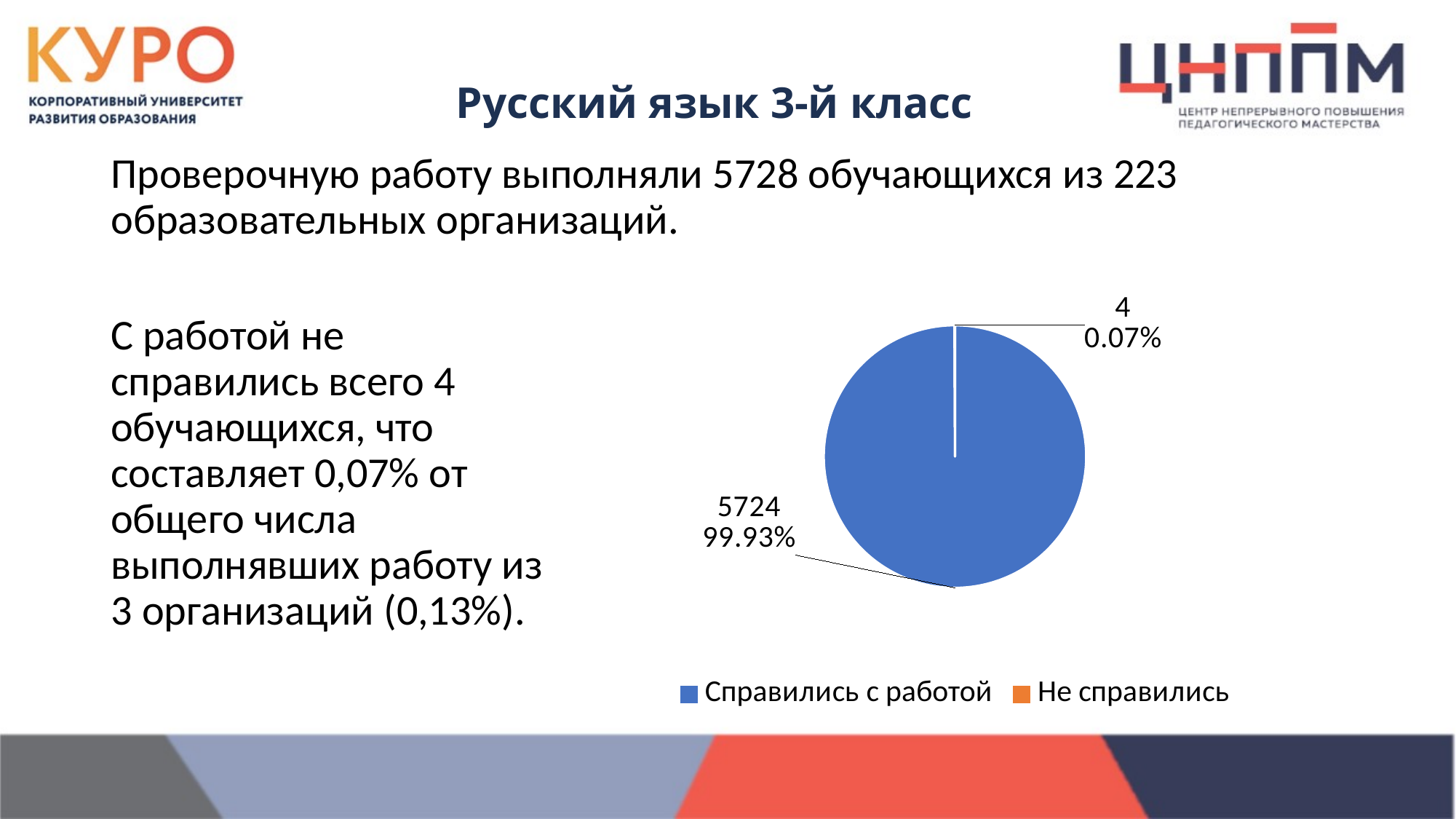
What is the difference between the values for "Справились с работой" and "Не справились"? 5720 What share of the pie does "Справились с работой" take? 99.93% What kind of chart is shown on the slide? pie chart Which is larger: the value for "Справились с работой" or for "Не справились"? Справились с работой How many entries does the legend of the pie chart list? 2 What is the value for "Справились с работой" in the pie chart? 5724 What is the value for "Не справились" in the pie chart? 4 What share of the pie does "Не справились" take? 0.07% Which category has the largest slice in the pie chart? Справились с работой What colour is the "Не справились" entry in the legend? orange How many slices does the pie chart have? 2 Which category has the smallest slice in the pie chart? Не справились